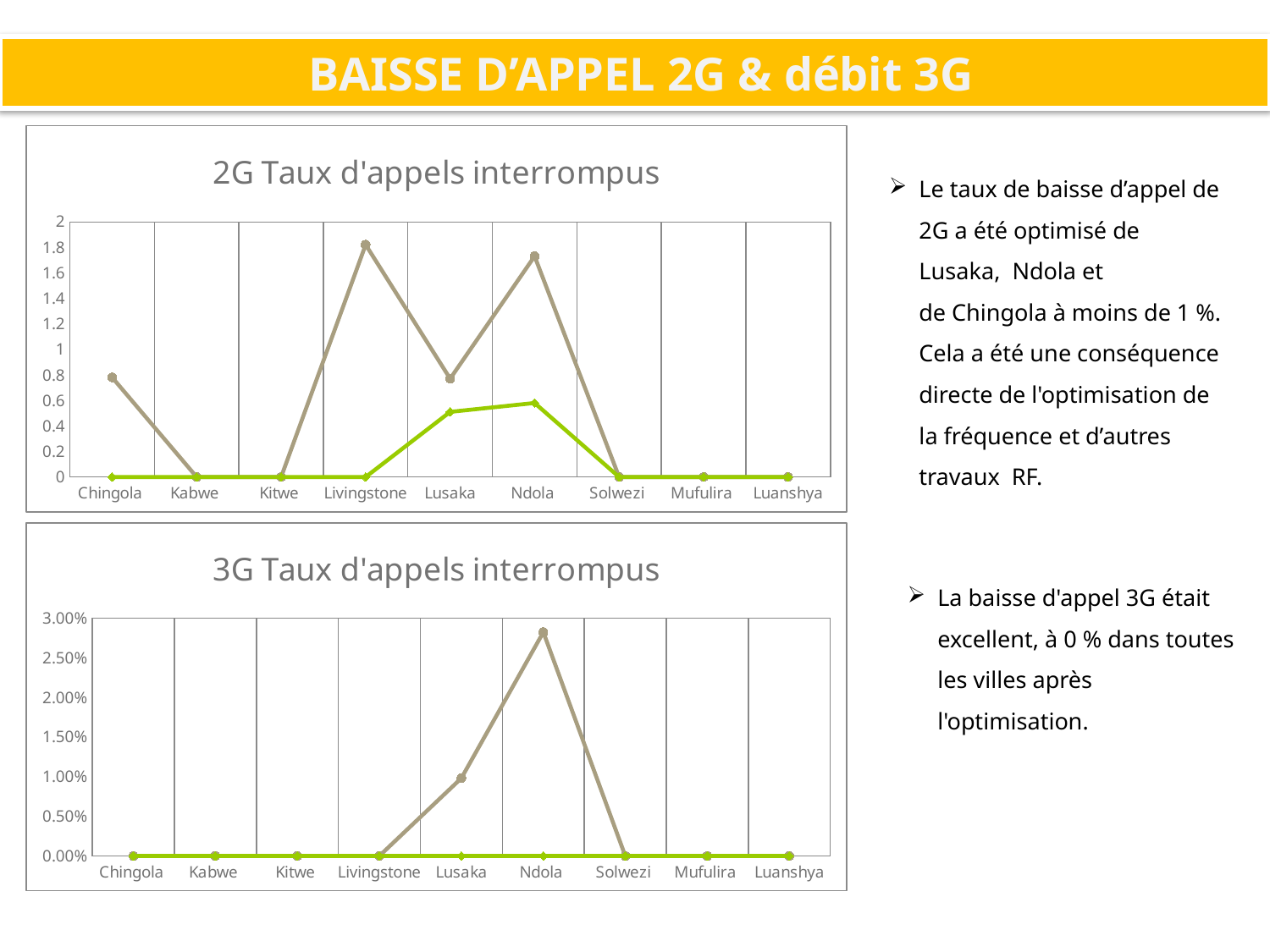
In the '2G Taux d'appels interrompus' chart, what is the grey line value for Solwezi? 0 What is the title of the top chart on the slide? 2G Taux d'appels interrompus In the '3G Taux d'appels interrompus' chart, is the grey line value for Lusaka greater or less than 1.50%? less In the '2G Taux d'appels interrompus' chart, is the grey line value for Chingola greater or less than 1? less How many cities are shown on the x axis of the '2G Taux d'appels interrompus' chart? 9 In the '2G Taux d'appels interrompus' chart, is the grey line value for Livingstone greater or less than 1.6? greater In the '3G Taux d'appels interrompus' chart, which city has the highest value on the grey line? Ndola In the '3G Taux d'appels interrompus' chart, what is the grey line value for Kabwe? 0.00% In the '2G Taux d'appels interrompus' chart, which city has the highest value on the grey line? Livingstone What kind of chart is the '2G Taux d'appels interrompus' chart? line chart In the '2G Taux d'appels interrompus' chart, which has the larger grey line value, Livingstone or Lusaka? Livingstone